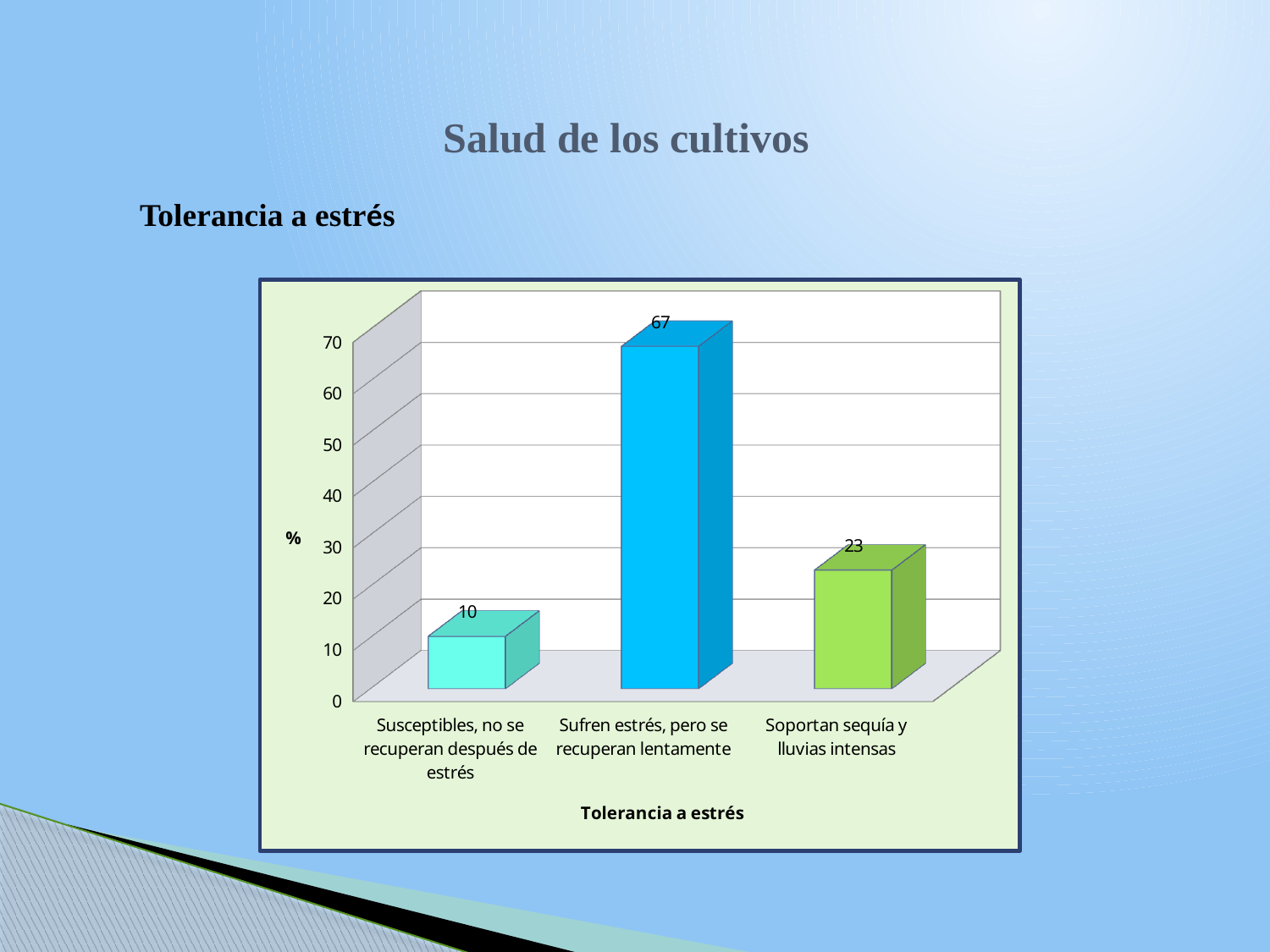
Which is larger: the value for "Soportan sequía y lluvias intensas" or for "Susceptibles, no se recuperan después de estrés"? Soportan sequía y lluvias intensas What is the difference between the values for "Soportan sequía y lluvias intensas" and "Susceptibles, no se recuperan después de estrés"? 13 What kind of chart is shown on the slide? bar chart What is the value for "Soportan sequía y lluvias intensas"? 23 How many categories are shown on the x axis? 3 What is the value for "Susceptibles, no se recuperan después de estrés"? 10 Which category has the highest value? Sufren estrés, pero se recuperan lentamente Is the value for "Sufren estrés, pero se recuperan lentamente" greater or less than 60? greater What is the label of the x axis? Tolerancia a estrés Which category has the lowest value? Susceptibles, no se recuperan después de estrés What is the difference between the values for "Sufren estrés, pero se recuperan lentamente" and "Soportan sequía y lluvias intensas"? 44 What is the value for "Sufren estrés, pero se recuperan lentamente"? 67